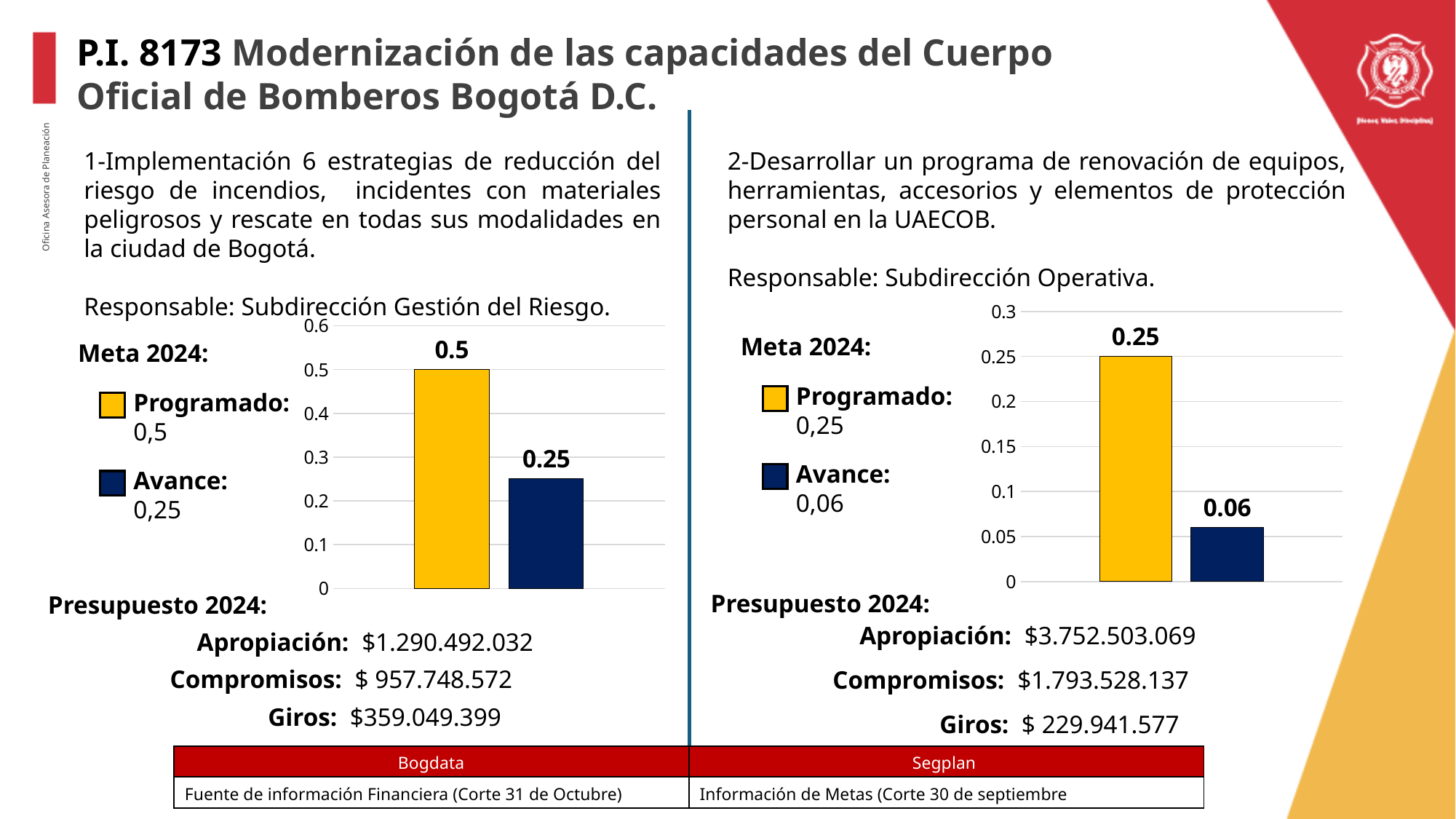
In the right chart, what is the value of the Avance bar? 0.06 In the left chart, what is the value of the Avance bar? 0.25 In the right chart, what is the difference between the Programado and Avance values? 0.19 In the right chart, which bar is the lowest? Avance In the left chart, which bar is higher, Programado or Avance? Programado In the left chart, what is the difference between the Programado and Avance values? 0.25 In the left chart, what is the value of the Programado bar? 0.5 In the left chart, what colour is the Programado bar? Yellow In the right chart, is the value for Avance greater or less than 0.1? less In the right chart, what is the value of the Programado bar? 0.25 What type of chart is shown on the left side of the slide? Bar chart How many bars are plotted in the right chart? 2